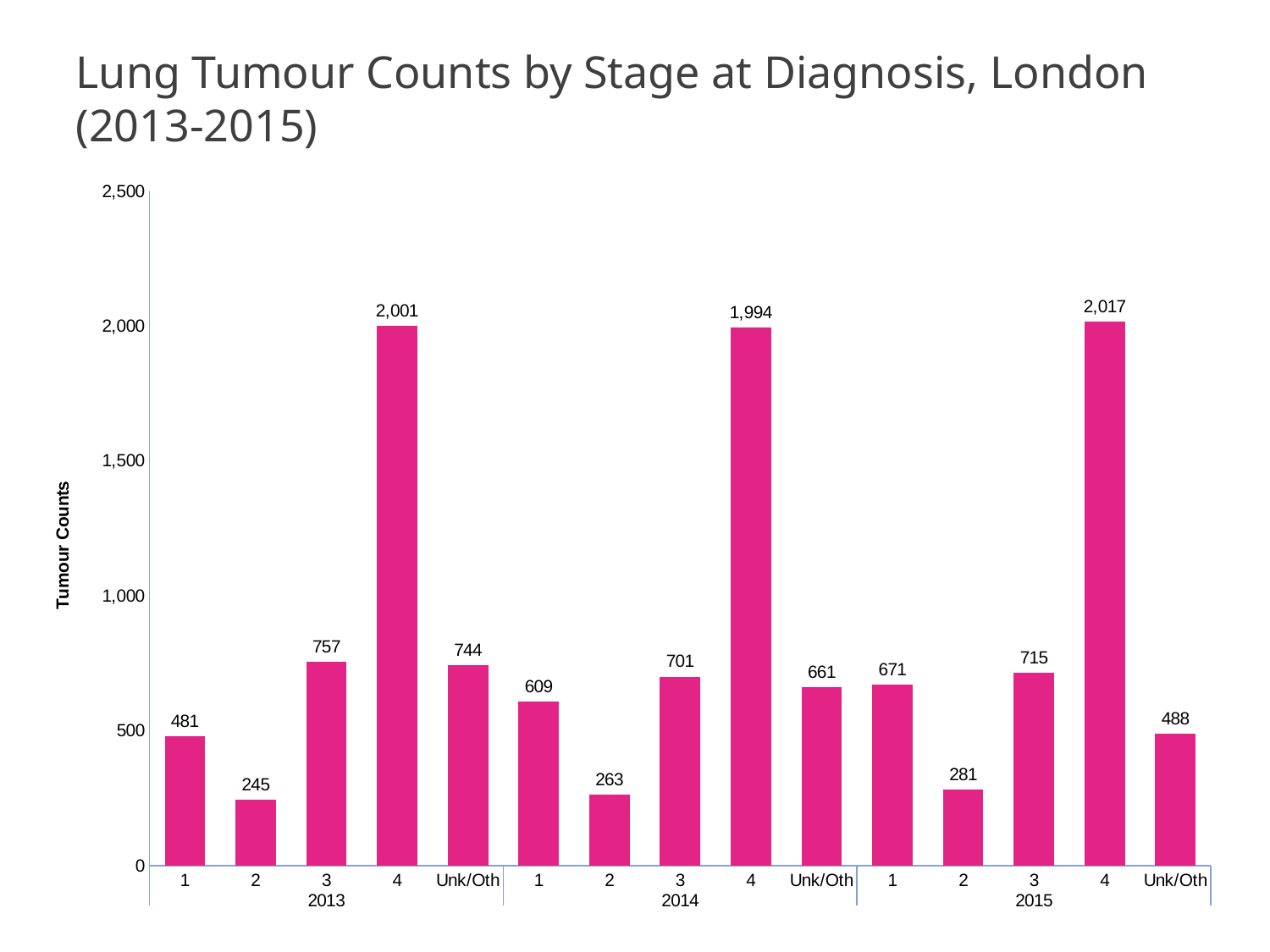
What is the difference between the stage 4 counts in 2015 and 2014? 23 What is the label of the vertical axis? Tumour Counts What is the tumour count for stage 2 in 2015? 281 Which is larger, the stage 3 count in 2013 or the stage 3 count in 2015? Stage 3 in 2013 What is the difference between the stage 1 counts in 2015 and 2013? 190 What is the tumour count for Unk/Oth in 2014? 661 What kind of chart is shown on the slide? Bar chart What is the tumour count for stage 4 in 2013? 2,001 How many bars are plotted on the chart? 15 Is the value for stage 1 in 2014 greater or less than 500? greater Which bar has the lowest tumour count on the chart? Stage 2, 2013 Which bar has the highest tumour count on the chart? Stage 4, 2015